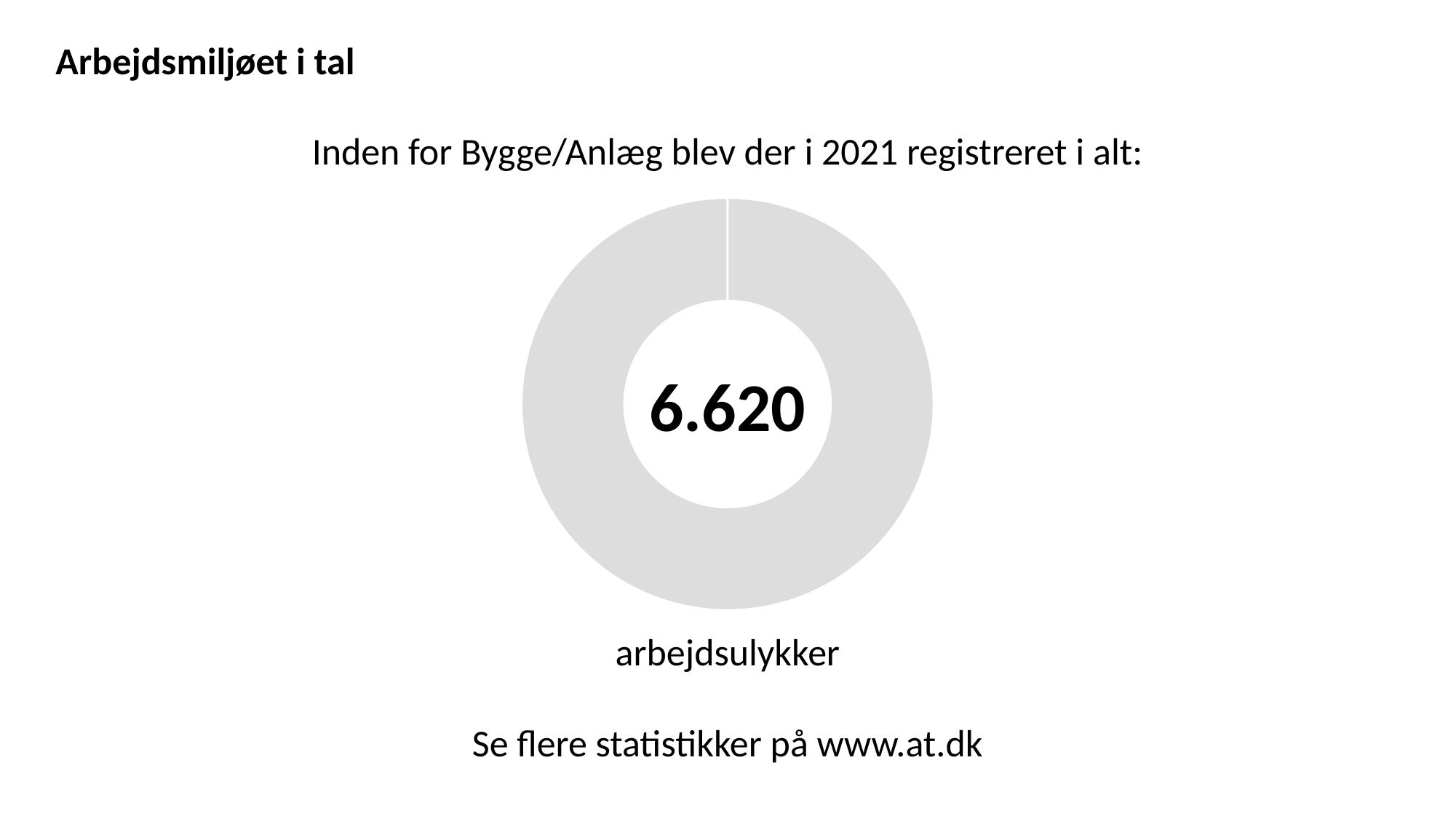
Which year does the figure in the donut chart refer to? 2021 What kind of chart is shown on the slide? Donut chart What does the number in the donut chart represent, according to the label below it? arbejdsulykker How many slices does the donut chart contain? 1 What value is printed in the centre of the donut chart? 6.620 How many work accidents (arbejdsulykker) were registered within Bygge/Anlæg in 2021 according to the chart? 6.620